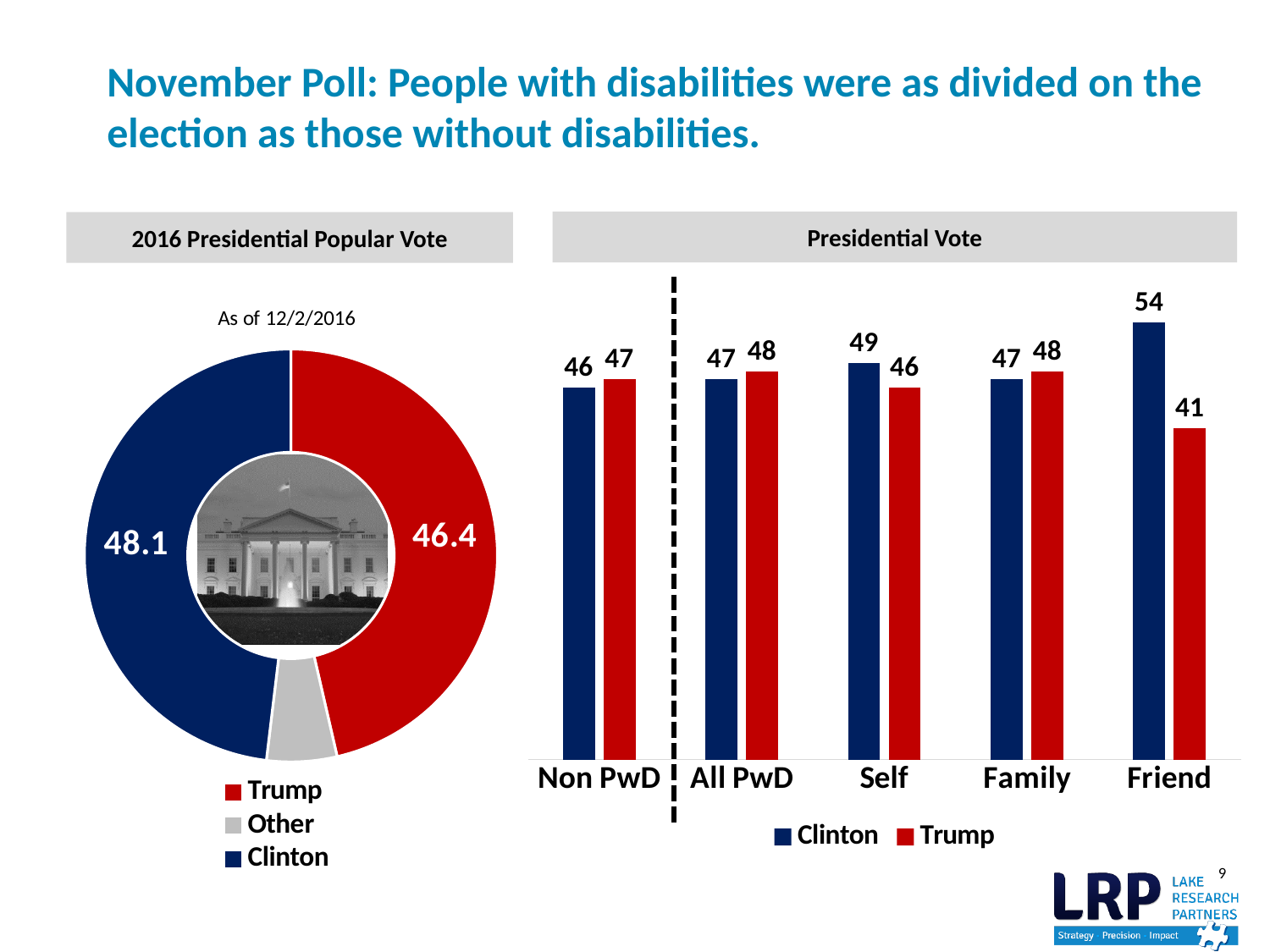
In the 'Presidential Vote' bar chart, which is larger in the Self category, Clinton or Trump? Clinton How many categories are shown on the x axis of the 'Presidential Vote' bar chart? 5 In the '2016 Presidential Popular Vote' chart, what is the difference between the Clinton and Trump values? 1.7 In the 'Presidential Vote' bar chart, which category has the lowest Trump value? Friend In the '2016 Presidential Popular Vote' chart, what is the value for Clinton? 48.1 In the 'Presidential Vote' bar chart, what is the value for Clinton in the Friend category? 54 What kind of chart is the '2016 Presidential Popular Vote' chart? Pie chart (donut) In the 'Presidential Vote' bar chart, what is the value for Trump in the Self category? 46 How many series does the legend of the 'Presidential Vote' chart list? 2 In the 'Presidential Vote' bar chart, what is the value for Trump in the Non PwD category? 47 In the 'Presidential Vote' bar chart, which category has the highest Clinton value? Friend In the 'Presidential Vote' bar chart, what is the difference between the Clinton and Trump values in the Friend category? 13